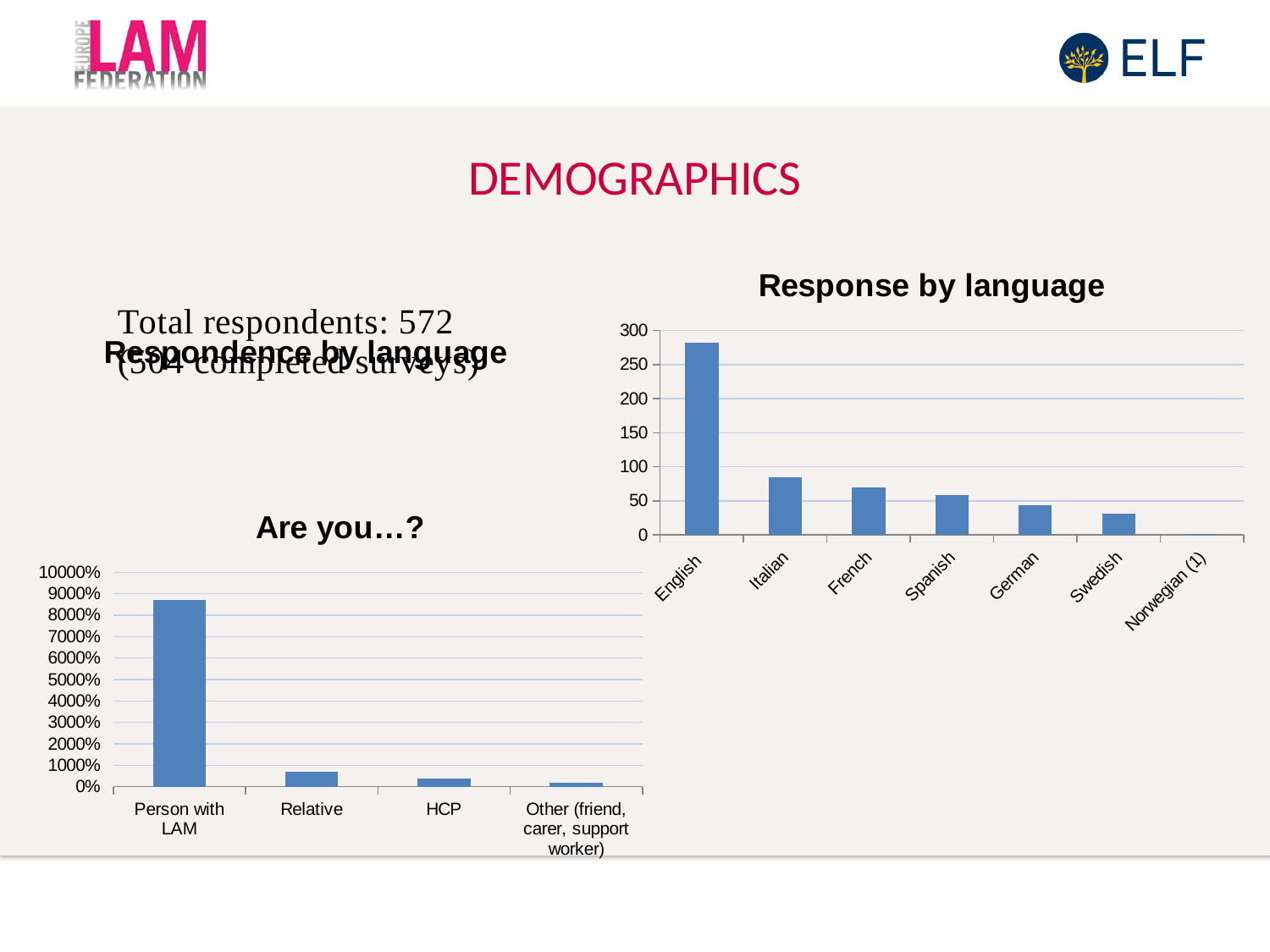
What kind of chart is the 'Are you…?' chart? bar chart In the 'Are you…?' chart, is the value for Relative greater or less than 1000%? less In the 'Response by language' chart, which language has the highest number of responses? English In the 'Response by language' chart, is the value for English greater or less than 250? greater In the 'Response by language' chart, which language has the lowest number of responses? Norwegian (1) How many languages are shown in the 'Response by language' chart? 7 In the 'Response by language' chart, is the value for German greater or less than 50? less In the 'Are you…?' chart, which category has the lowest value? Other (friend, carer, support worker) In the 'Response by language' chart, do the values rise or fall from left to right along the x axis? fall In the 'Are you…?' chart, which category has the highest value? Person with LAM In the 'Response by language' chart, which has more responses, Italian or French? Italian